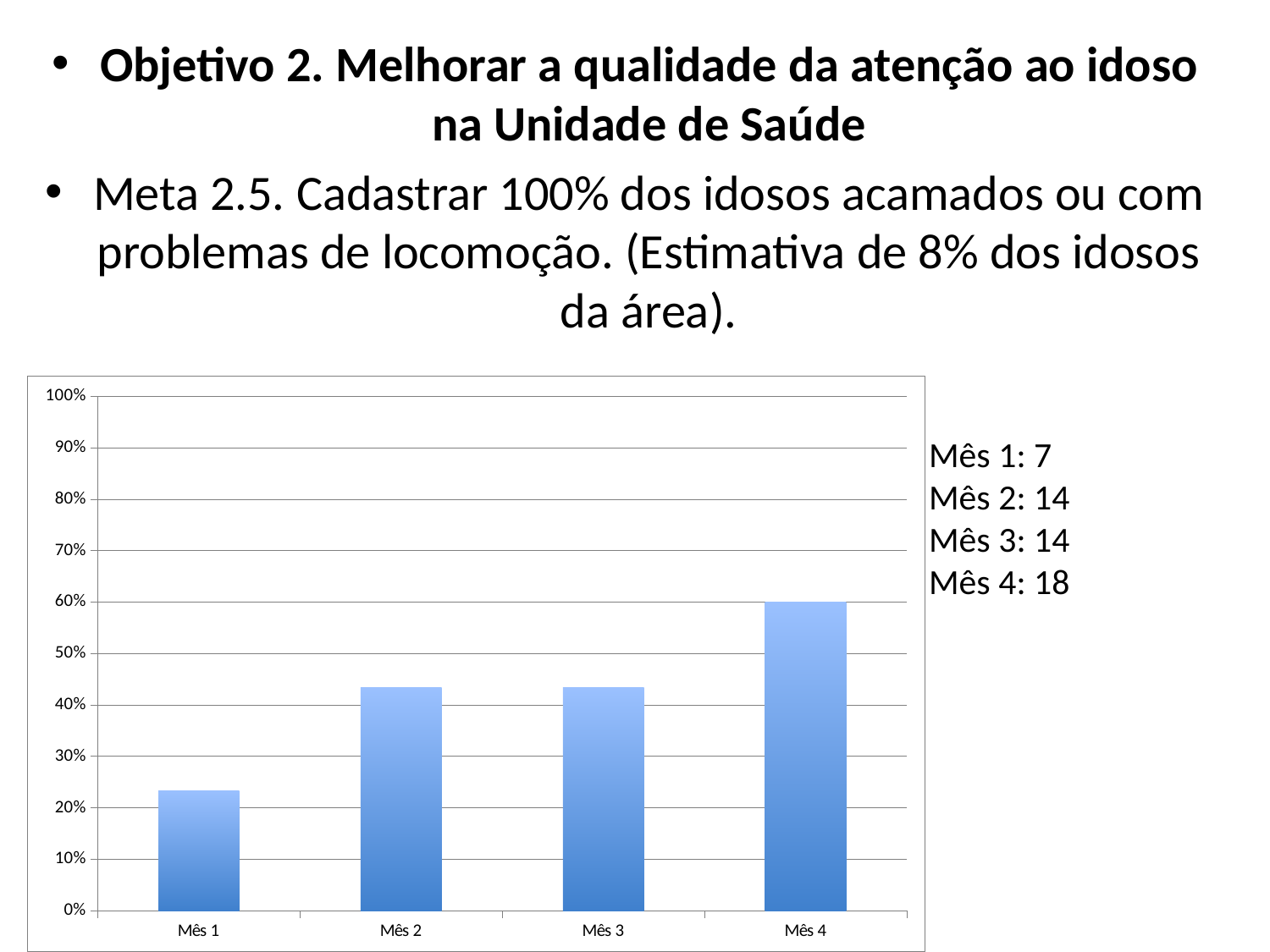
Is the value for Mês 1 greater or less than 20%? greater How many categories (months) are plotted on the chart? 4 Which month has the highest bar on the chart? Mês 4 Is the value for Mês 4 greater or less than 50%? greater What is the highest value shown on the vertical axis of the chart? 100% Which is larger, the value for Mês 1 or the value for Mês 4? Mês 4 Which month has the lowest bar on the chart? Mês 1 What kind of chart is shown on the slide? bar chart Is the value for Mês 1 greater or less than 30%? less Do the values generally rise or fall from Mês 1 to Mês 4? rise